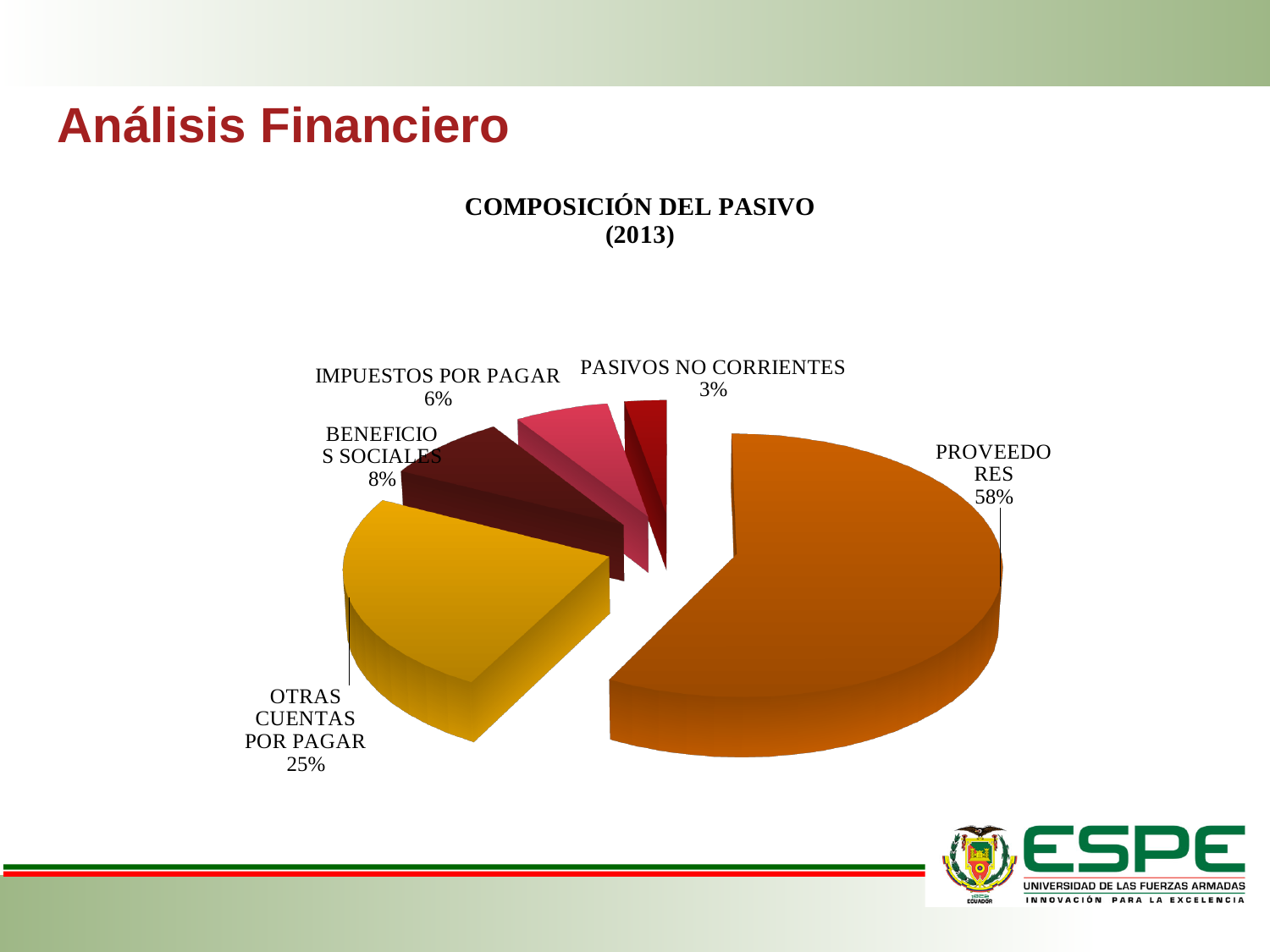
What kind of chart is shown on the slide? Pie chart Which category has the smallest slice of the pie? PASIVOS NO CORRIENTES What share of the pie does OTRAS CUENTAS POR PAGAR represent? 25% What share of the pie does PROVEEDORES represent? 58% What is the title of the chart? COMPOSICIÓN DEL PASIVO (2013) What is the value shown for BENEFICIOS SOCIALES? 8% What is the value shown for PASIVOS NO CORRIENTES? 3% Which category has the largest slice of the pie? PROVEEDORES Which is larger, the share for BENEFICIOS SOCIALES or the share for IMPUESTOS POR PAGAR? BENEFICIOS SOCIALES What is the value shown for IMPUESTOS POR PAGAR? 6% How many slices does the pie chart have? 5 What is the difference between the shares of PROVEEDORES and OTRAS CUENTAS POR PAGAR? 33%